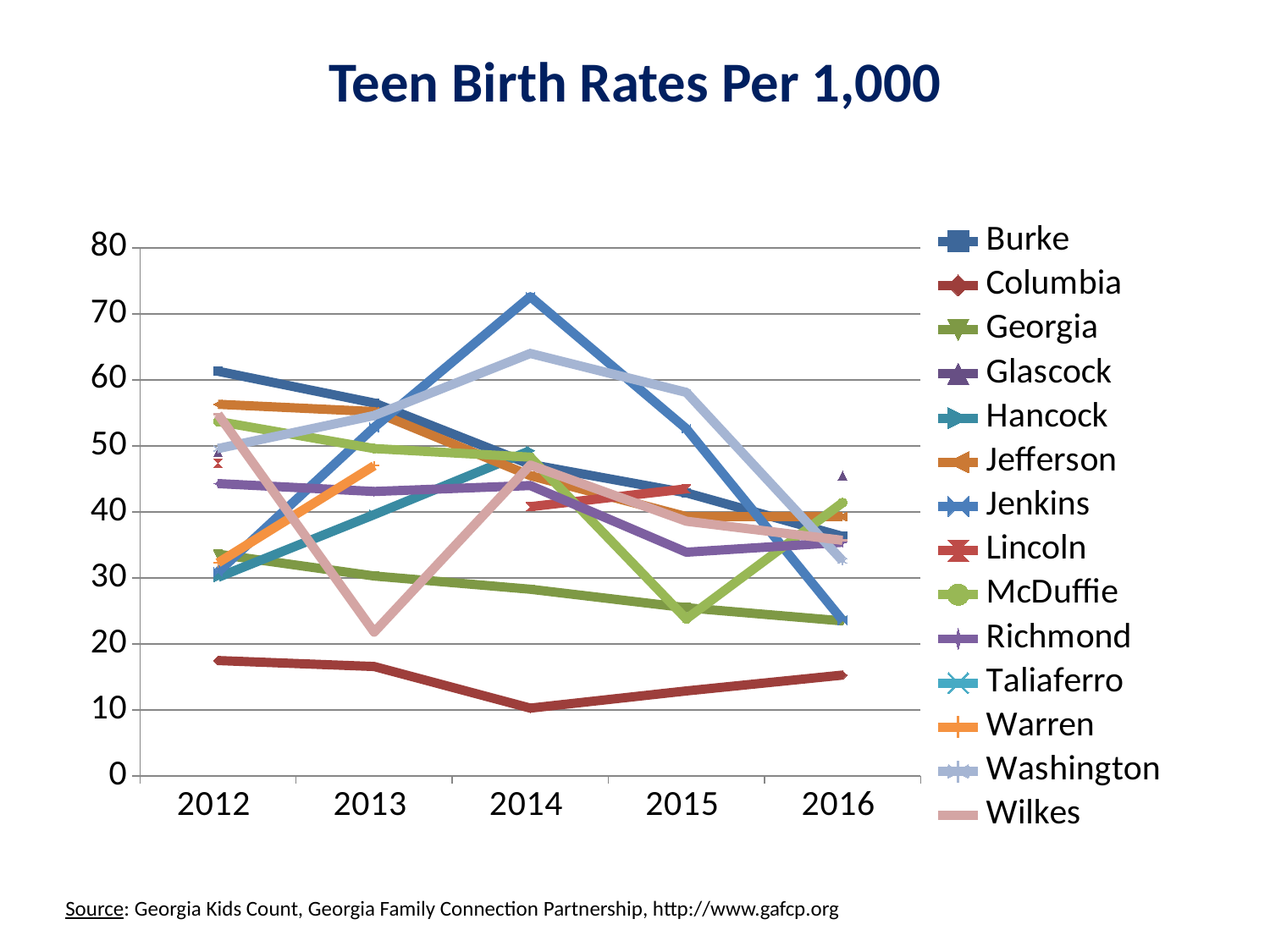
Does the Georgia line rise or fall from 2012 to 2016? fall How many series does the legend list? 14 Which series has the highest value in 2014? Jenkins Which is larger in 2015, the value for Washington or the value for Wilkes? Washington How many years are shown on the x axis? 5 Is the value for Wilkes in 2013 greater or less than 30? less What is the title of the chart? Teen Birth Rates Per 1,000 Which series has the lowest value in 2012? Columbia What kind of chart is shown on the slide? line chart Is the value for Jenkins in 2014 greater or less than 70? greater Is the value for Columbia in 2014 greater or less than 20? less Which is larger in 2012, the value for Burke or the value for Columbia? Burke